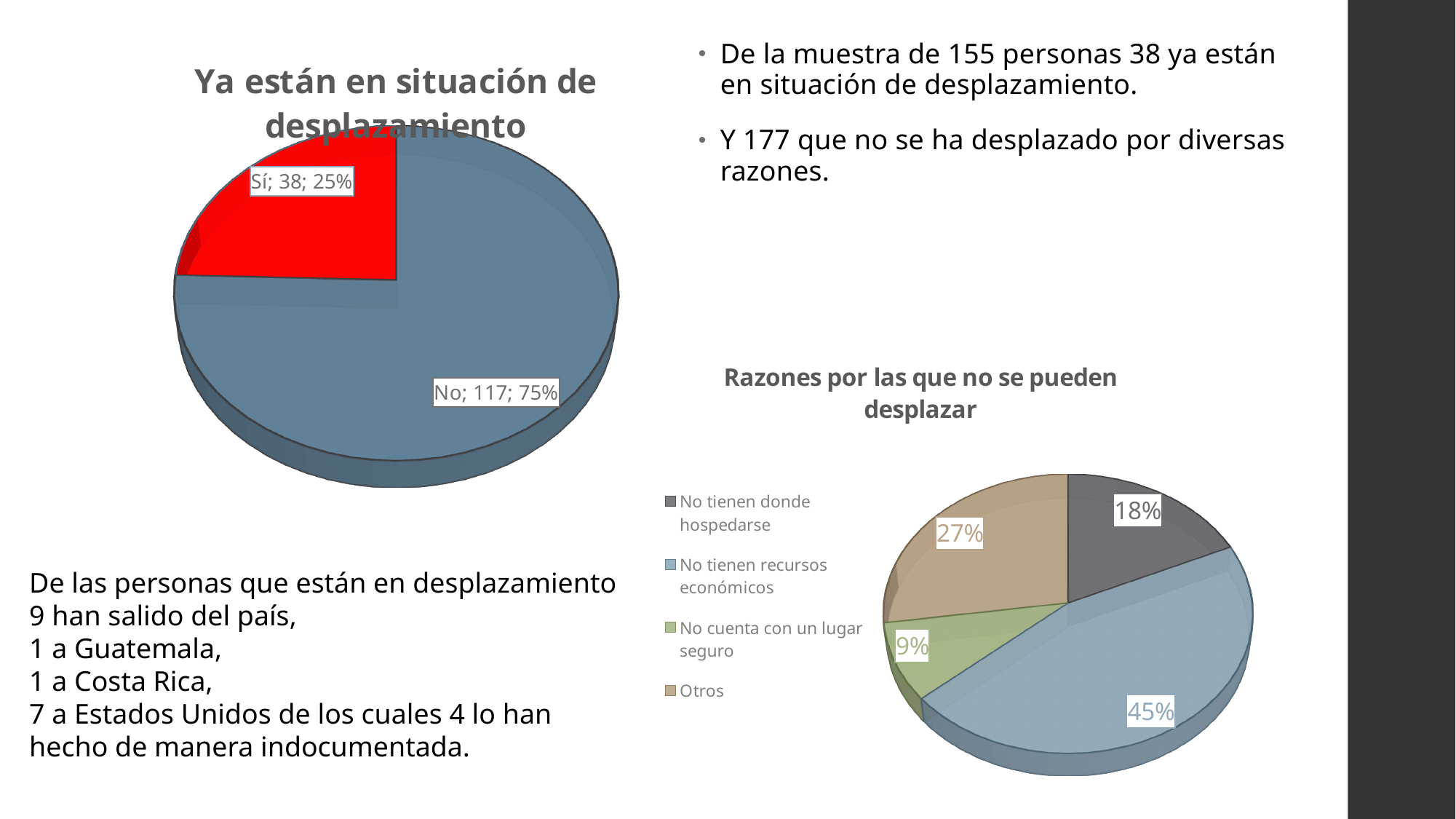
In the chart titled "Ya están en situación de desplazamiento", what share of the pie does "No" represent? 75% In the chart titled "Ya están en situación de desplazamiento", what is the value for "Sí"? 38 In the chart titled "Ya están en situación de desplazamiento", what is the value for "No"? 117 In the chart titled "Razones por las que no se pueden desplazar", what is the share for "Otros"? 27% In the chart titled "Razones por las que no se pueden desplazar", which category has the largest share? No tienen recursos económicos In the chart titled "Razones por las que no se pueden desplazar", which category has the smallest share? No cuenta con un lugar seguro In the chart titled "Razones por las que no se pueden desplazar", which is larger: "No tienen donde hospedarse" or "Otros"? Otros In the chart titled "Ya están en situación de desplazamiento", what is the difference between the values for "No" and "Sí"? 79 In the chart titled "Ya están en situación de desplazamiento", what share of the pie does "Sí" represent? 25% In the chart titled "Razones por las que no se pueden desplazar", how many categories does the legend list? 4 What kind of chart is the one titled "Ya están en situación de desplazamiento"? Pie chart In the chart titled "Razones por las que no se pueden desplazar", what is the share for "No tienen recursos económicos"? 45%